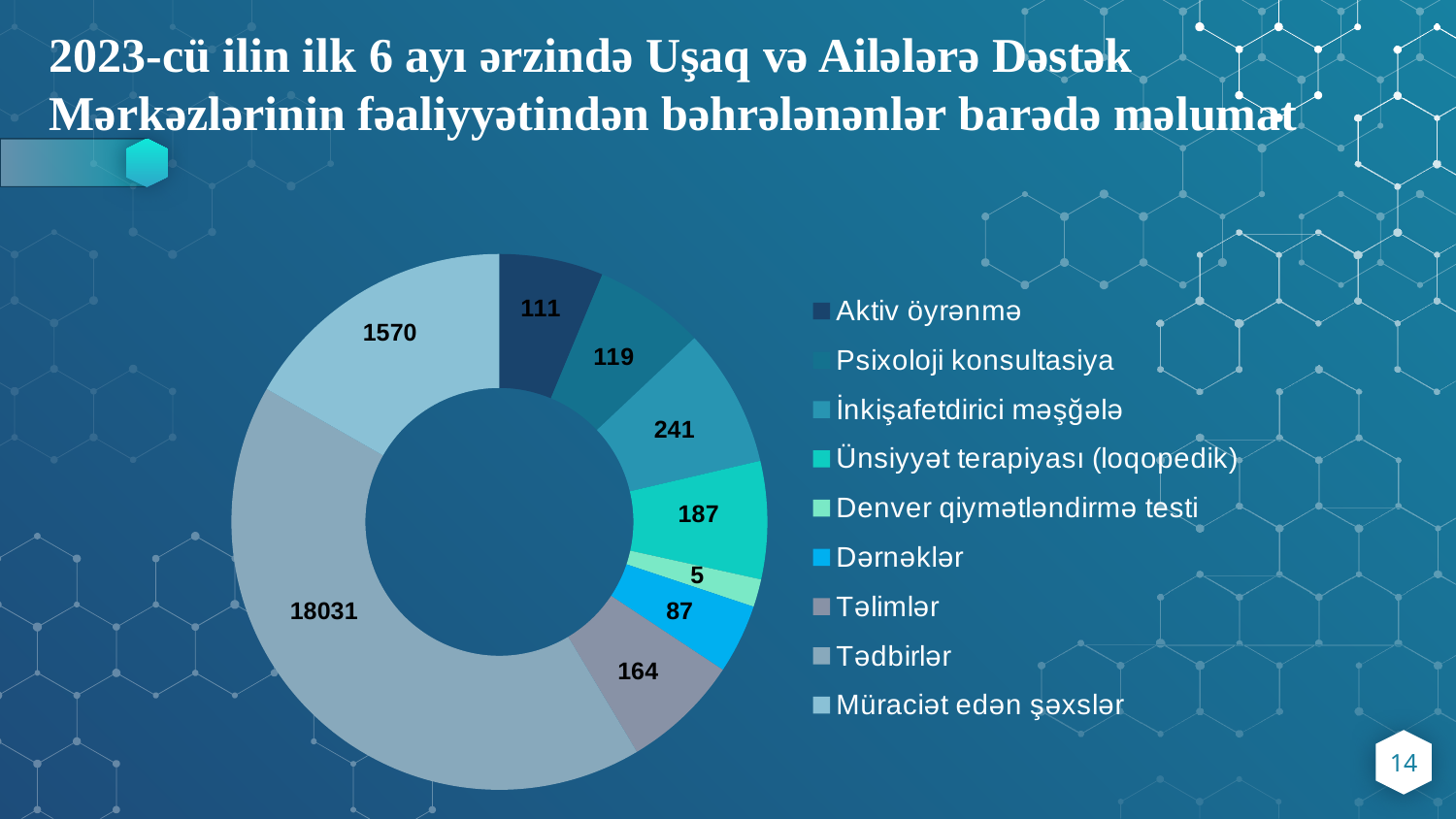
How many categories does the chart show? 9 What is the value for Müraciət edən şəxslər? 1570 Which category has the highest value? Tədbirlər What kind of chart is shown on the slide? doughnut chart What is the difference between the values for İnkişafetdirici məşğələ and Ünsiyyət terapiyası (loqopedik)? 54 Which is larger, the value for Aktiv öyrənmə or the value for Psixoloji konsultasiya? Psixoloji konsultasiya What is the difference between the values for Təlimlər and Dərnəklər? 77 Which category is listed first in the legend? Aktiv öyrənmə Which category has the lowest value? Denver qiymətləndirmə testi What is the value for Denver qiymətləndirmə testi? 5 What is the value for Təlimlər? 164 What is the value for Tədbirlər? 18031